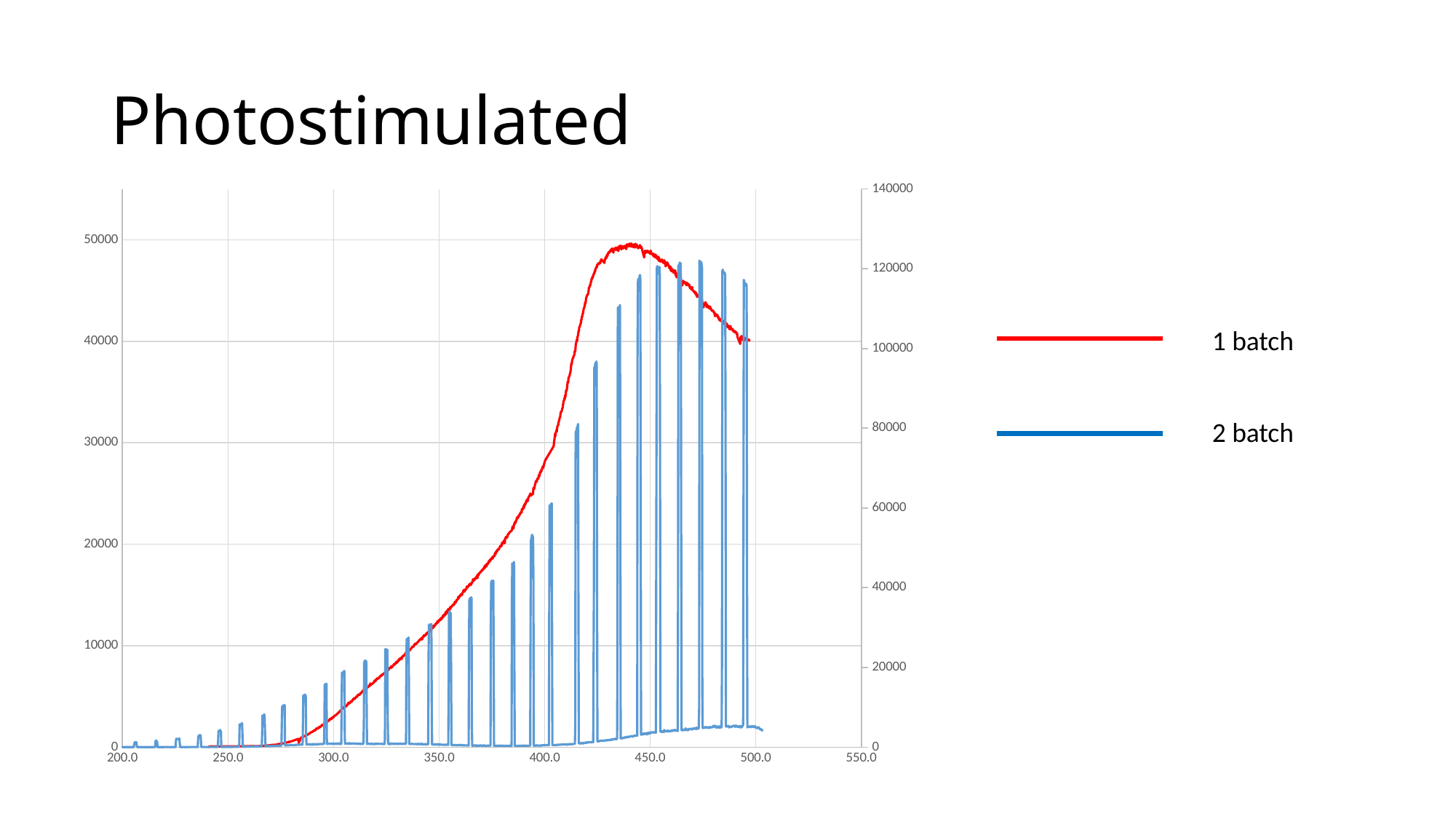
What are the two series named in the legend? 1 batch and 2 batch What colour is the line for the series "1 batch"? red Do the peaks of the "2 batch" series rise or fall along the x axis between 250.0 and 450.0? rise How many series does the legend list? 2 Does the "1 batch" line rise or fall along the x axis between 300.0 and 400.0? rise What kind of chart is shown on the slide? line chart Does the "1 batch" line rise or fall along the x axis between 450.0 and 500.0? fall What is the title of the slide containing the chart? Photostimulated